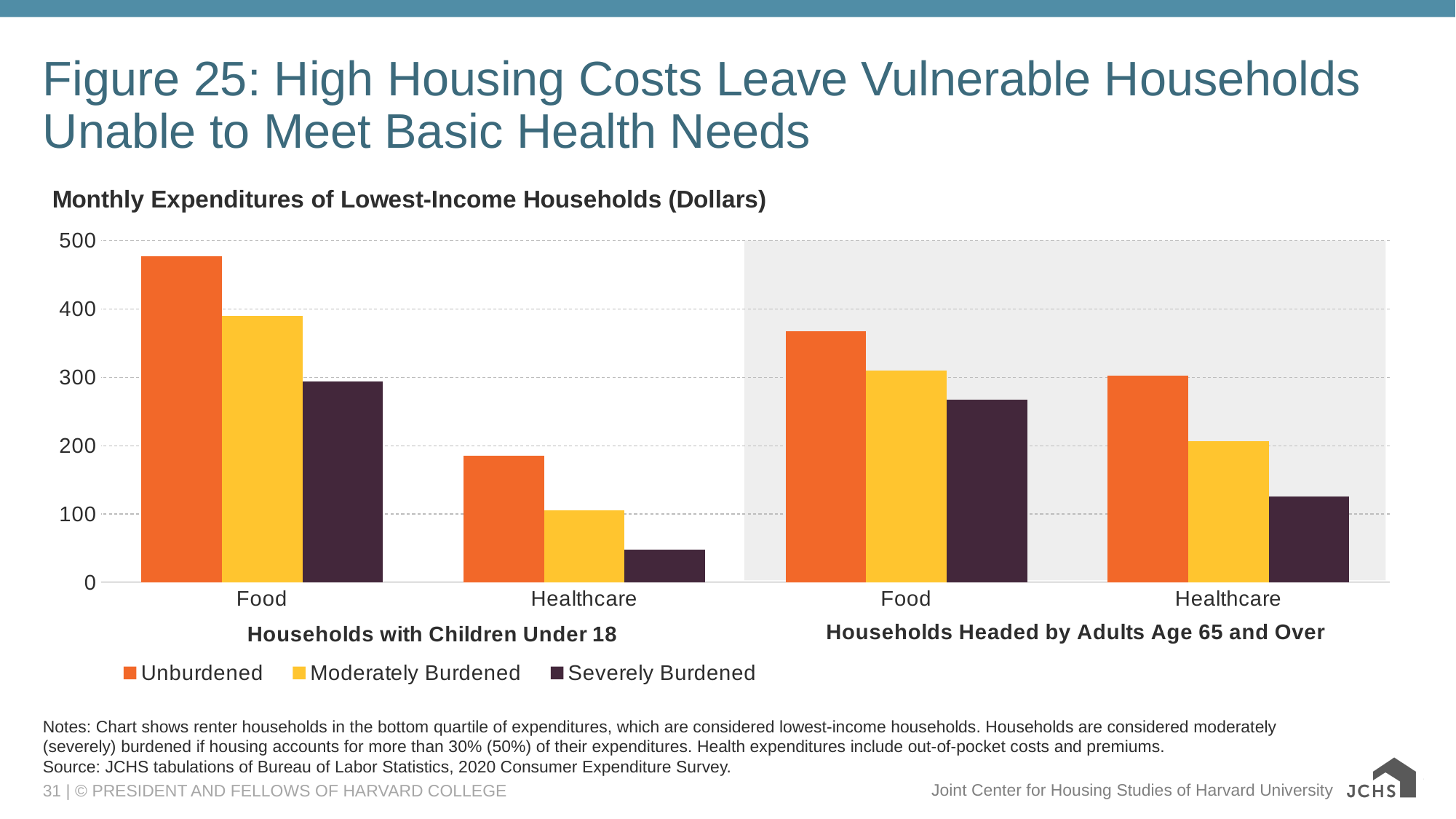
Is the Severely Burdened value for Food among Households Headed by Adults Age 65 and Over greater or less than 300? less What is the title of the chart? Monthly Expenditures of Lowest-Income Households (Dollars) Which series is shown in orange in the legend? Unburdened How many series does the legend list? 3 Is the Unburdened value for Healthcare among Households with Children Under 18 greater or less than 200? less Which bar is the tallest on the chart? Unburdened, Food, Households with Children Under 18 Is the Unburdened value for Food among Households with Children Under 18 greater or less than 400? greater Within each category group, do the bars rise or fall going from Unburdened to Severely Burdened? fall What kind of chart is shown on the slide? bar chart Which bar is the shortest on the chart? Severely Burdened, Healthcare, Households with Children Under 18 For Unburdened households, is Food spending higher for Households with Children Under 18 or for Households Headed by Adults Age 65 and Over? Households with Children Under 18